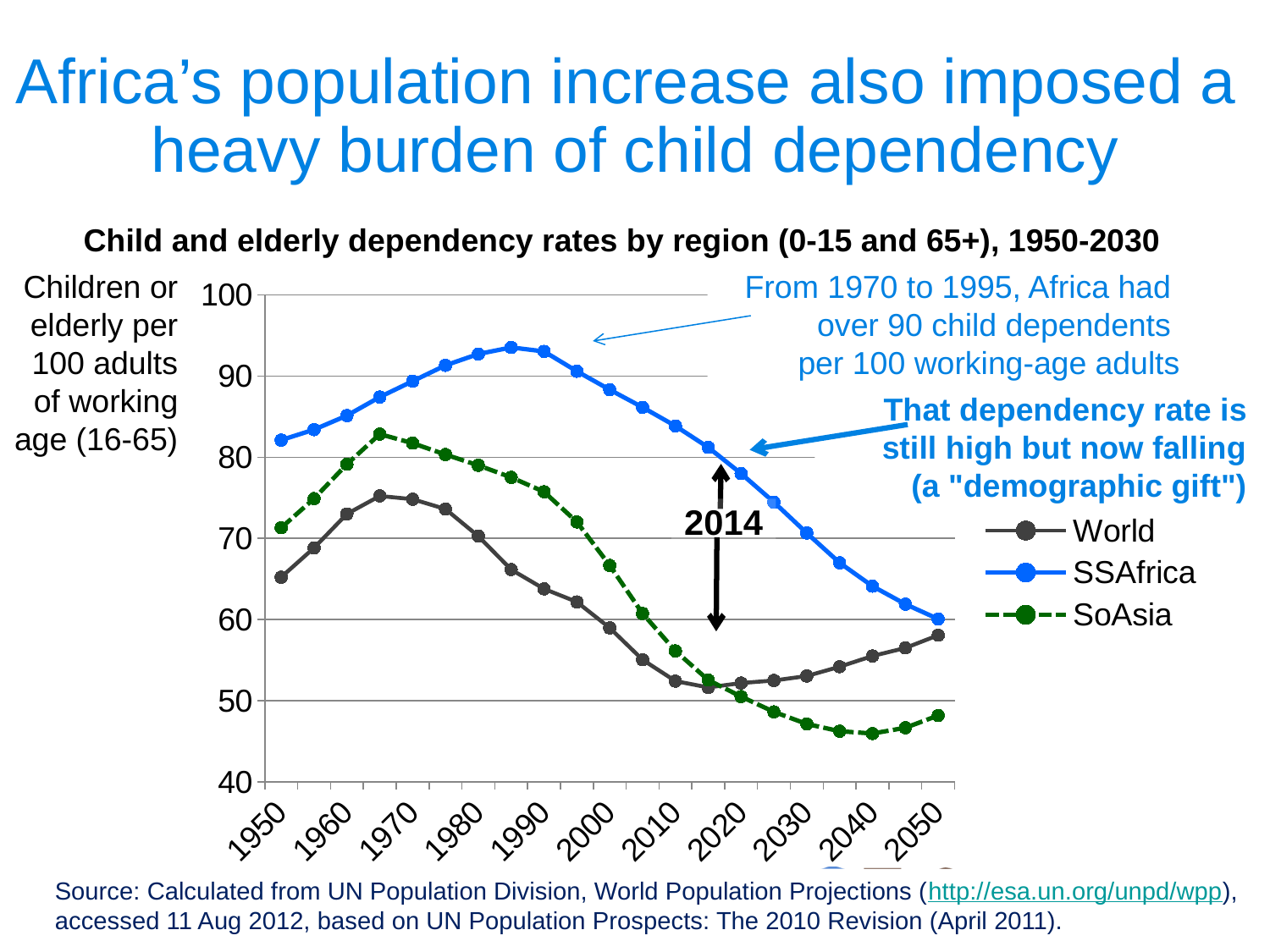
Does the SSAfrica series rise or fall from 1990 to 2050? fall Is the value for SoAsia in 1970 greater or less than 80? greater Is the value for SoAsia in 2040 greater or less than 50? less In 2040, which is larger, the value for World or the value for SoAsia? World Which series is drawn with a dashed line? SoAsia Is the value for SSAfrica in 1990 greater or less than 90? greater What is the title of the chart? Child and elderly dependency rates by region (0-15 and 65+), 1950-2030 What kind of chart is shown on the slide? line chart Which series has the lowest value in 2050? SoAsia Which series has the highest value in 1980? SSAfrica How many series does the legend list? 3